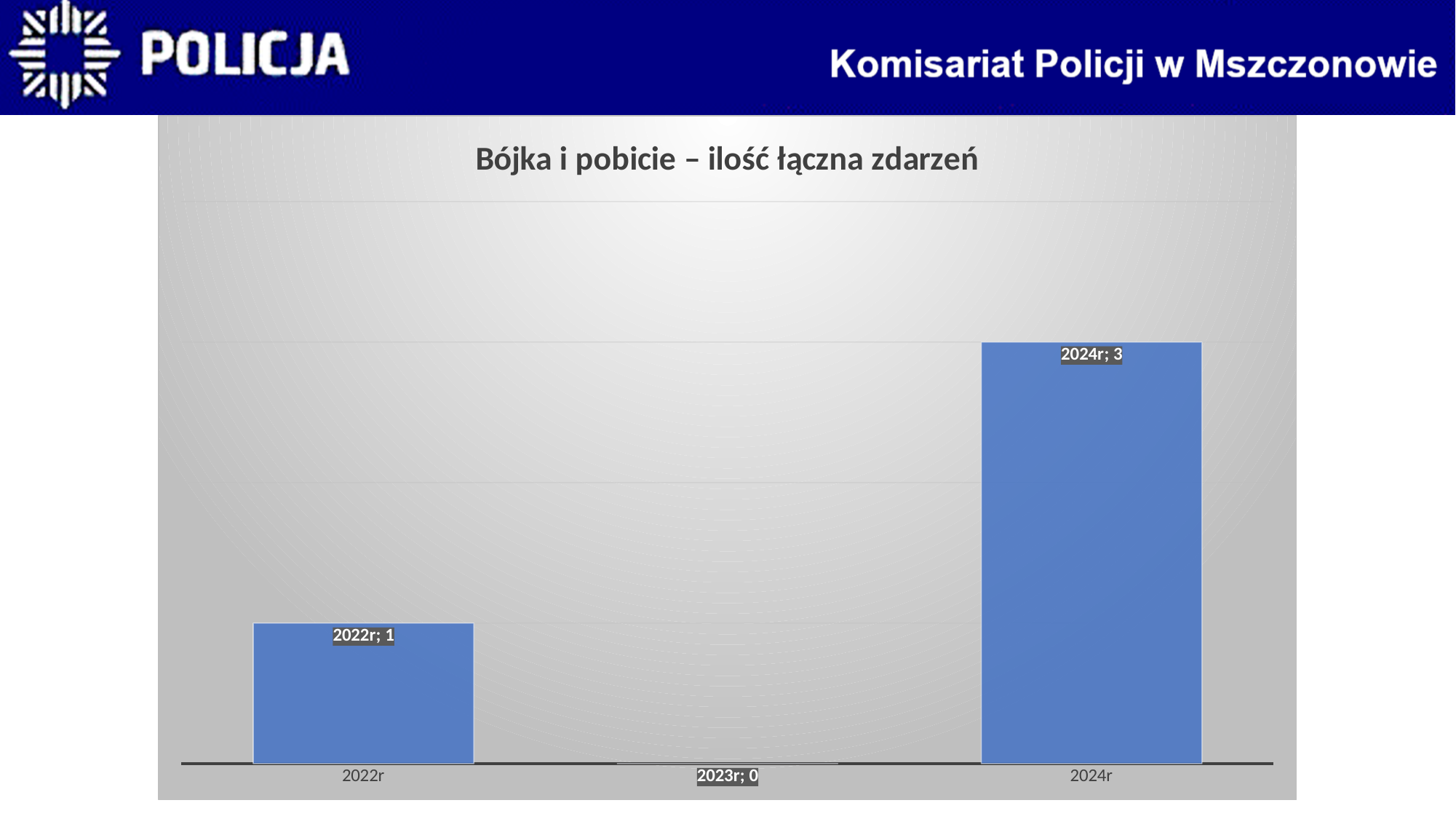
Which year has the lowest value? 2023r What kind of chart is shown on the slide? bar chart What colour are the bars in the chart? blue What is the total of the values for 2022r, 2023r and 2024r? 4 Which is larger, the value for 2022r or the value for 2024r? 2024r What is the value for 2023r? 0 What is the value for 2024r? 3 What is the value for 2022r? 1 What is the difference between the values for 2024r and 2022r? 2 How many categories are shown on the x axis? 3 Which year has the highest value? 2024r What is the title of the chart? Bójka i pobicie – ilość łączna zdarzeń